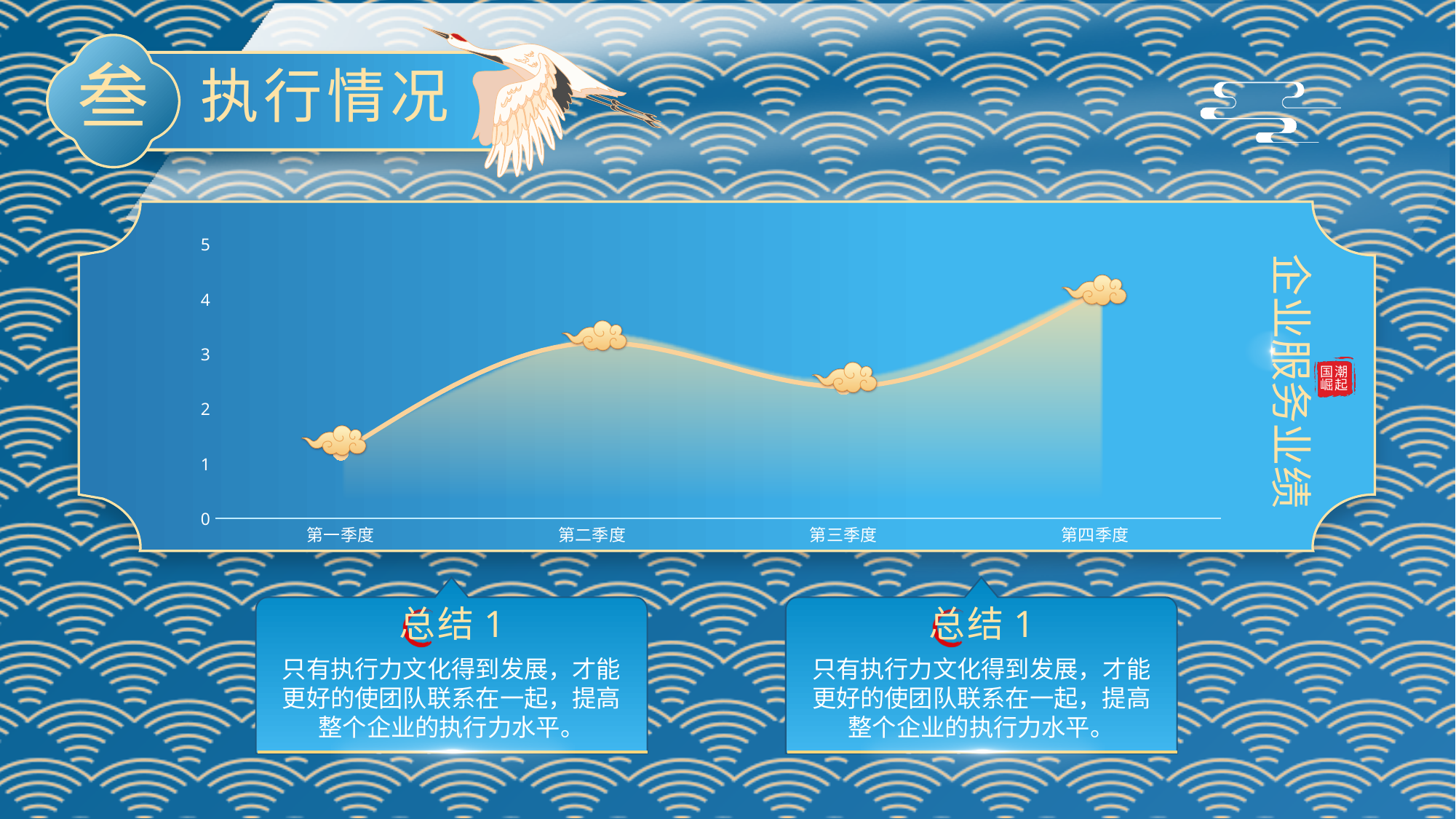
Is the value for 第二季度 greater or less than 4? less Which quarter has the highest value in the chart? 第四季度 What kind of chart is shown on the slide? line chart Which has the larger value, 第一季度 or 第三季度? 第三季度 How many quarters are plotted on the x axis of the chart? 4 Which has the larger value, 第二季度 or 第三季度? 第二季度 Does the value rise or fall from 第一季度 to 第二季度? rise Is the value for 第一季度 greater or less than 2? less Which quarter has the lowest value in the chart? 第一季度 What is the title shown beside the chart? 企业服务业绩 Is the value for 第三季度 greater or less than 2? greater